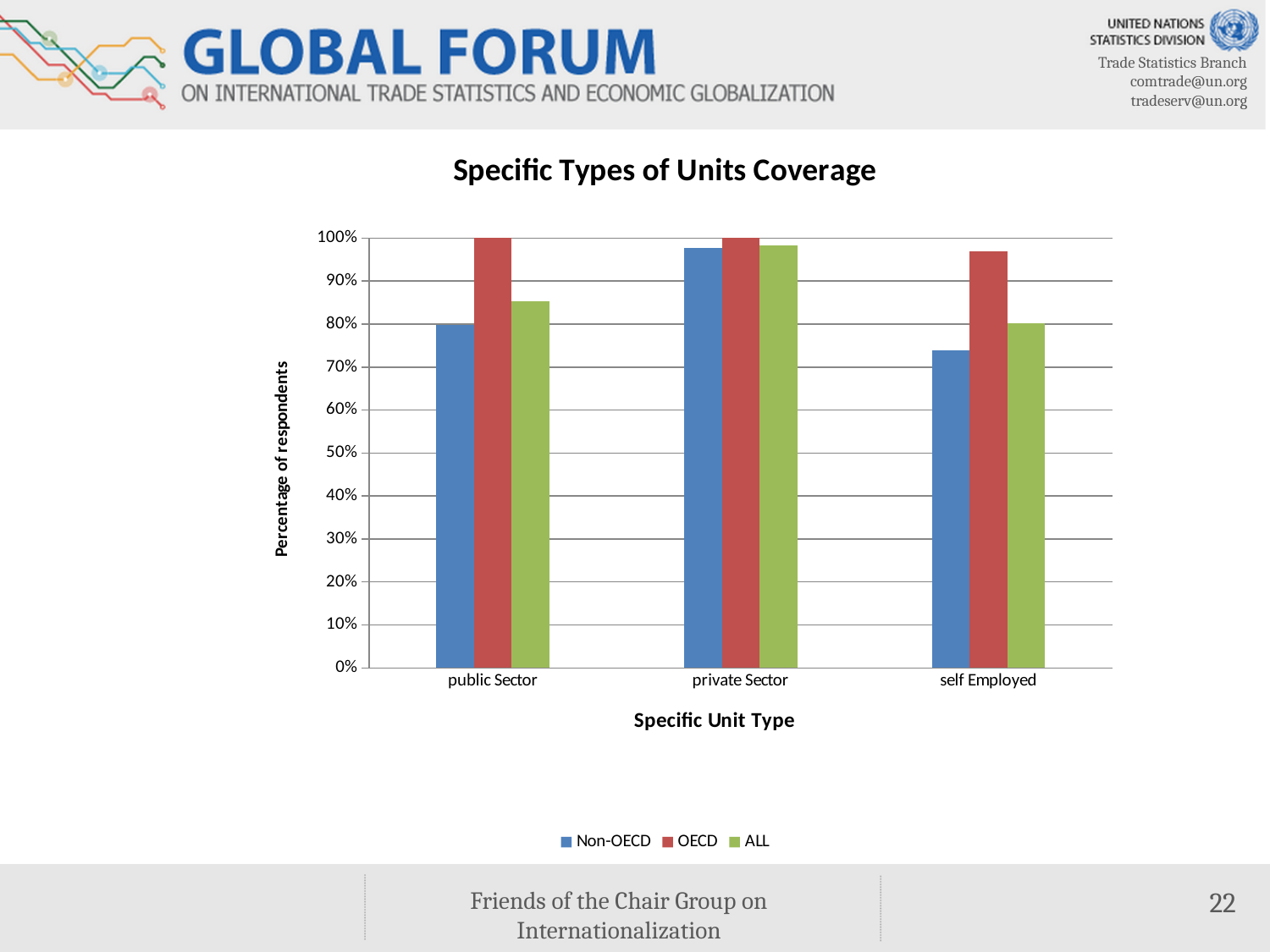
What is the value for OECD in the public Sector category? 100% Which category has the lowest Non-OECD value? self Employed What type of chart is shown on the slide? bar chart In the self Employed category, which is larger, the OECD value or the Non-OECD value? OECD Is the value for ALL in the public Sector category greater or less than 90%? less How many categories are shown on the x axis? 3 Is the value for ALL in the private Sector category greater or less than 90%? greater How many series does the legend list? 3 What is the title of the chart? Specific Types of Units Coverage What is the value for OECD in the private Sector category? 100% What is the label of the y axis? Percentage of respondents Is the value for Non-OECD in the self Employed category greater or less than 80%? less